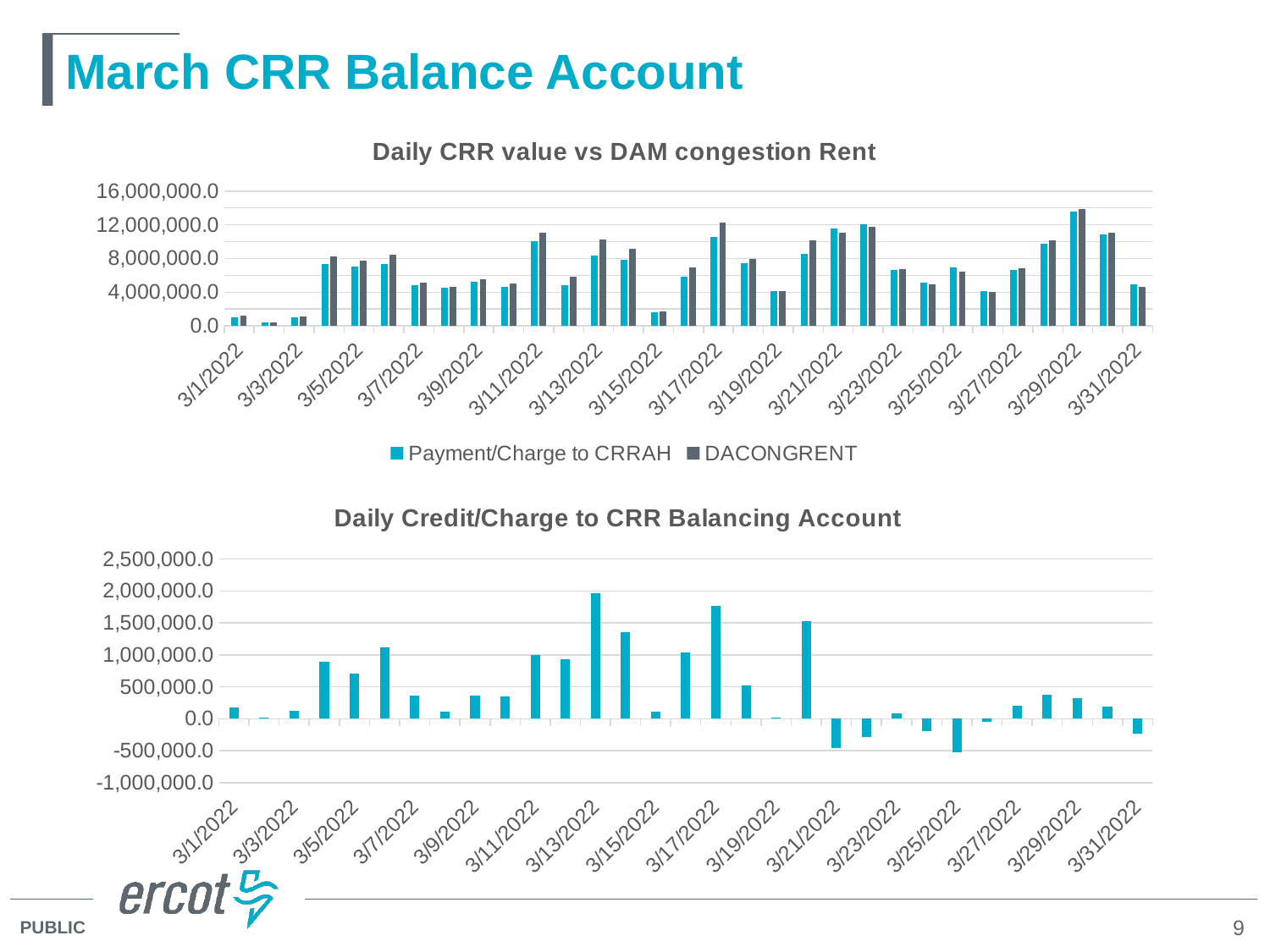
In the top chart "Daily CRR value vs DAM congestion Rent", which is larger for Payment/Charge to CRRAH: 3/29/2022 or 3/15/2022? 3/29/2022 What kind of chart is the top chart titled "Daily CRR value vs DAM congestion Rent"? bar chart In the bottom chart "Daily Credit/Charge to CRR Balancing Account", which date has the highest value? 3/13/2022 How many series does the legend of the top chart "Daily CRR value vs DAM congestion Rent" list? 2 In the bottom chart "Daily Credit/Charge to CRR Balancing Account", is the value for 3/21/2022 greater or less than 0.0? less In the bottom chart "Daily Credit/Charge to CRR Balancing Account", is the value for 3/17/2022 greater or less than 1,500,000.0? greater What is the title of the bottom chart on the slide? Daily Credit/Charge to CRR Balancing Account In the top chart "Daily CRR value vs DAM congestion Rent", what are the two series named in the legend? Payment/Charge to CRRAH and DACONGRENT In the top chart "Daily CRR value vs DAM congestion Rent", which date has the highest Payment/Charge to CRRAH value? 3/29/2022 In the top chart "Daily CRR value vs DAM congestion Rent", is the DACONGRENT value for 3/11/2022 greater or less than 8,000,000.0? greater